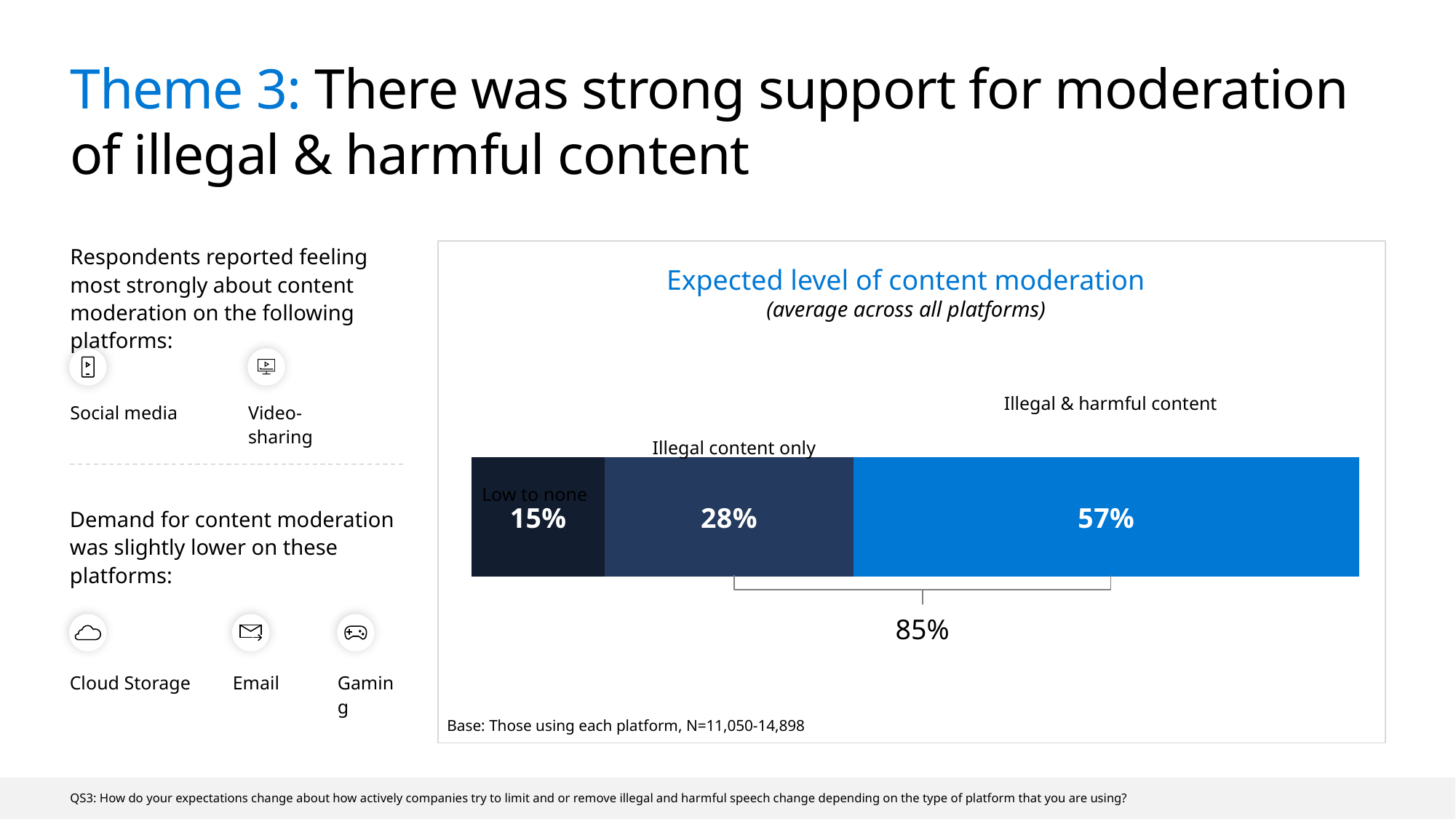
Which segment of the bar has the largest share? Illegal & harmful content What combined percentage is shown by the bracket under the bar for 'Illegal content only' and 'Illegal & harmful content'? 85% What percentage of respondents expected a 'Low to none' level of content moderation? 15% How many segments make up the stacked bar? 3 Which is larger: the share for 'Illegal content only' or the share for 'Low to none'? Illegal content only What is the title of the chart? Expected level of content moderation What percentage of respondents expected moderation of 'Illegal & harmful content'? 57% What is the difference between the 'Illegal & harmful content' share and the 'Illegal content only' share? 29% What kind of chart is shown on the slide? Stacked bar chart What percentage of respondents expected moderation of 'Illegal content only'? 28% What is the subtitle shown under the chart title? (average across all platforms) Which segment of the bar has the smallest share? Low to none